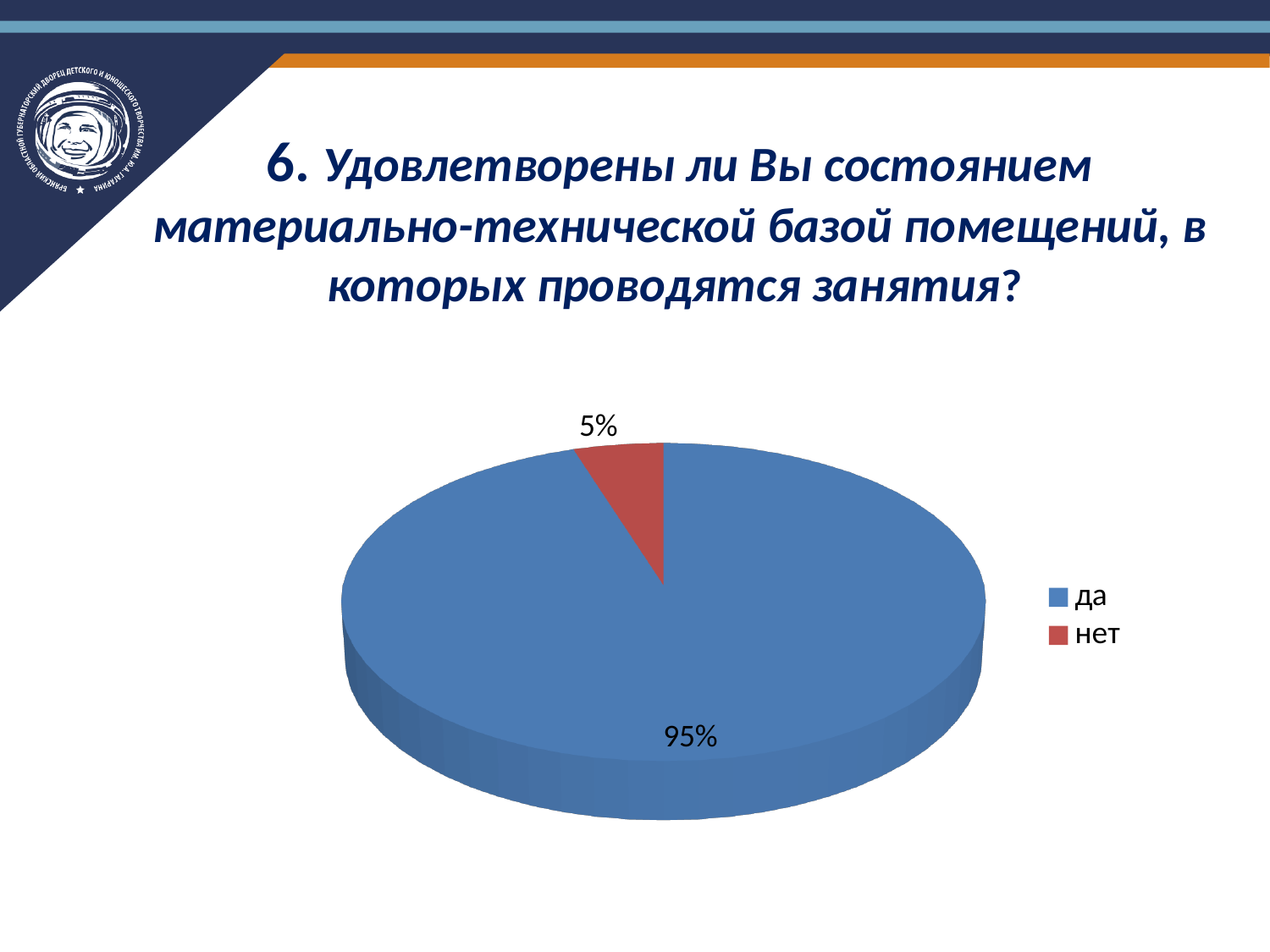
Which category has the largest slice of the pie? да What kind of chart is shown on the slide? pie chart What is the difference between the shares for "да" and "нет"? 90% What colour is the slice for "нет"? red How many entries does the legend list? 2 What colour is the slice for "да"? blue How many categories does the pie chart show? 2 Which category has the smallest slice of the pie? нет Which is larger, the share for "да" or the share for "нет"? да What share of the pie does "да" have? 95% What share of the pie does "нет" have? 5%